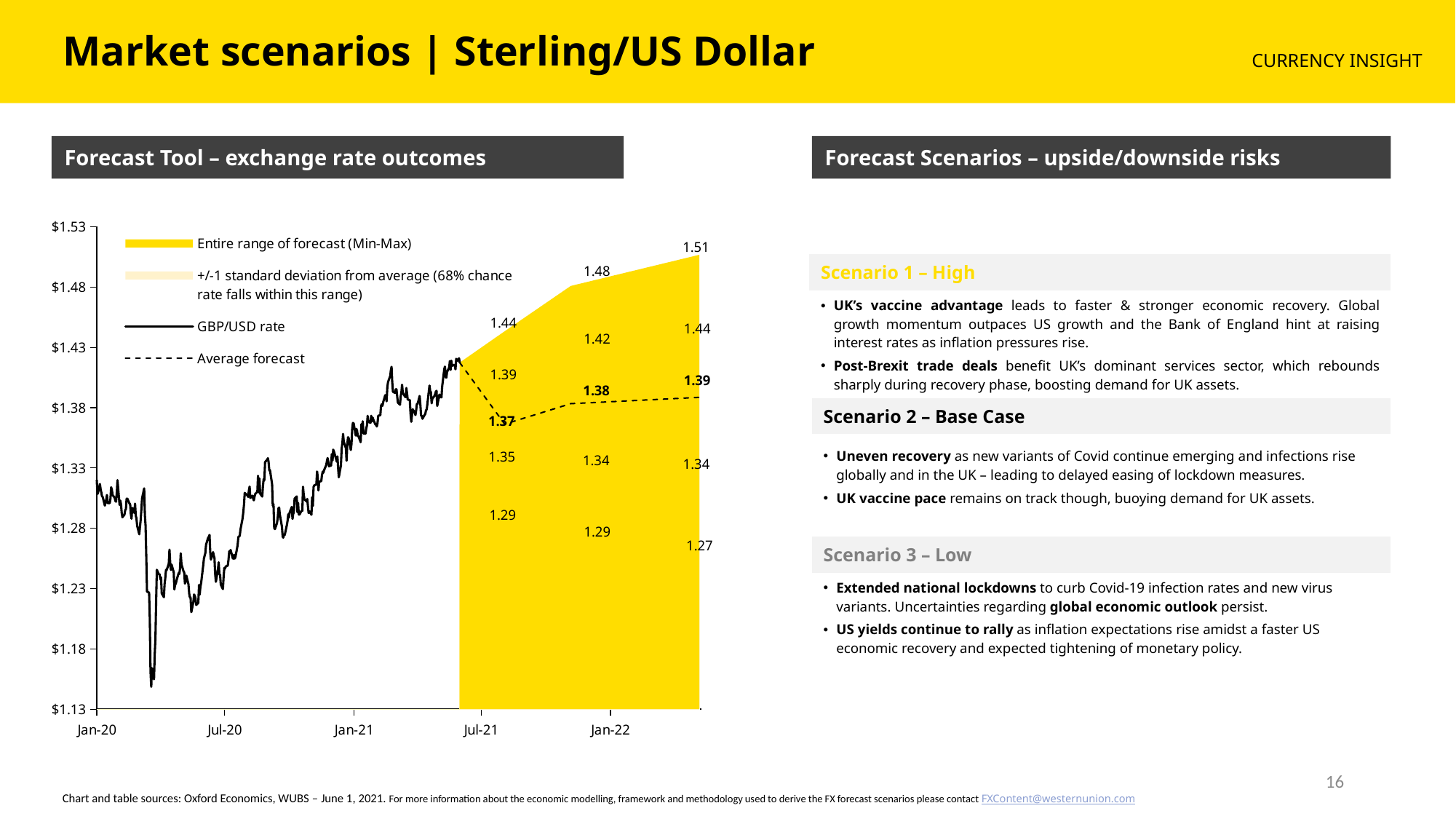
What is the average forecast value labelled at the first forecast point (around Jul-21)? 1.37 What is the maximum of the forecast range at the final (right-most) forecast point? 1.51 Is the lowest point of the GBP/USD rate line in 2020 greater or less than $1.18? less What kind of chart is shown under 'Forecast Tool – exchange rate outcomes'? line chart What is the title of the chart panel on the left of the slide? Forecast Tool – exchange rate outcomes What is the average forecast value labelled at the Jan-22 forecast point? 1.38 Which is larger: the maximum forecast at Jan-22 or the maximum forecast at the final forecast point? the final forecast point (1.51) Does the average forecast rise or fall from the first forecast point to the final forecast point? rise How many entries does the chart legend list? 4 What is the difference between the maximum (1.51) and minimum (1.27) of the forecast range at the final forecast point? 0.24 What is the difference between the maximum (1.48) and minimum (1.29) of the forecast range at the Jan-22 forecast point? 0.19 What is the minimum of the forecast range at the final (right-most) forecast point? 1.27